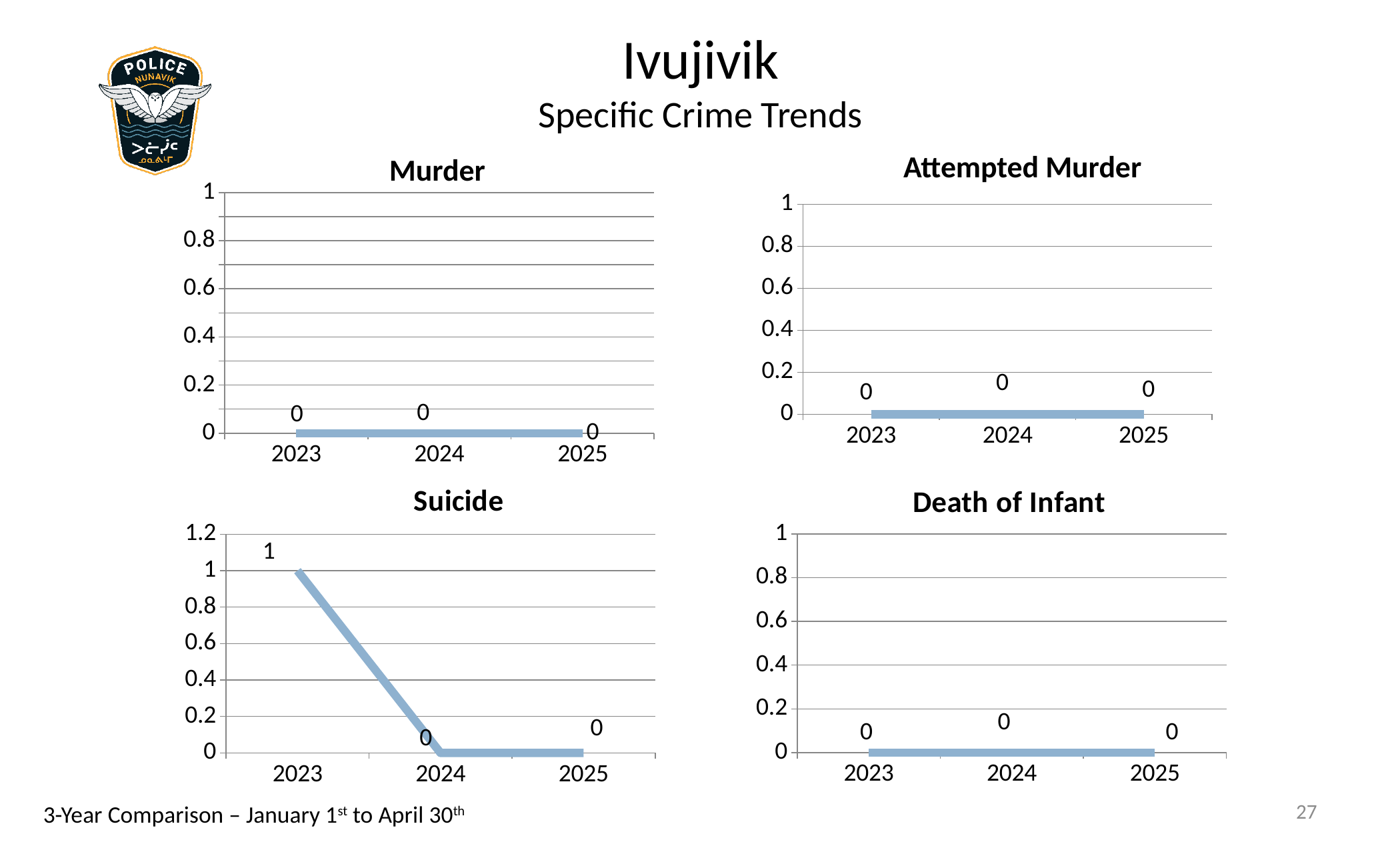
In the Suicide chart, do the values rise or fall from 2023 to 2025? fall In the Suicide chart, what is the difference between the 2023 and 2025 values? 1 What kind of chart is the Death of Infant chart? line chart How many years are plotted in the Murder chart? 3 In the Suicide chart, which is larger, the value for 2023 or the value for 2024? 2023 In the Suicide chart, which year has the highest value? 2023 In the Suicide chart, what is the value for 2024? 0 In the Death of Infant chart, what is the value for 2023? 0 How many charts are shown on the slide? 4 In the Attempted Murder chart, what is the value for 2024? 0 In the Murder chart, what is the value for 2025? 0 In the Suicide chart, what is the value for 2023? 1